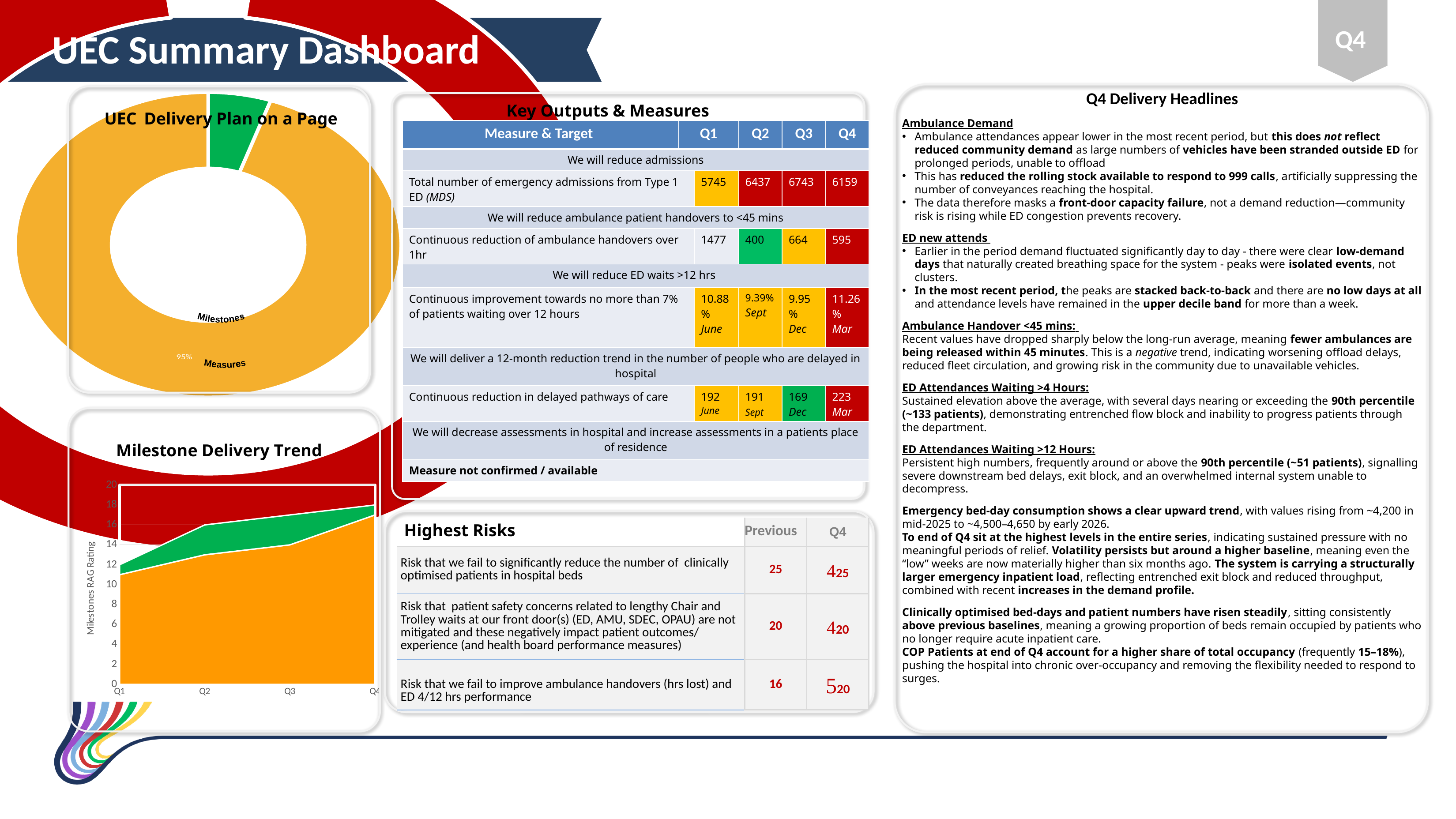
In the 'Milestone Delivery Trend' chart, in which quarter is the orange area lowest? Q1 In the 'Milestone Delivery Trend' chart, is the top of the orange area at Q1 greater or less than 12? less How many quarters are shown on the x axis of the 'Milestone Delivery Trend' chart? 4 What kind of chart is the 'UEC Delivery Plan on a Page' chart? Doughnut chart In the 'Milestone Delivery Trend' chart, is the top of the orange area at Q2 greater or less than 16? less In the 'Milestone Delivery Trend' chart, in which quarter is the orange area highest? Q4 In the 'Milestone Delivery Trend' chart, does the orange area rise or fall from Q1 to Q4? Rise What is the label on the y axis of the 'Milestone Delivery Trend' chart? Milestones RAG Rating What kind of chart is the 'Milestone Delivery Trend' chart? Area chart In the 'Milestone Delivery Trend' chart, is the orange area larger at Q4 or at Q1? Q4 What is the highest value shown on the y axis of the 'Milestone Delivery Trend' chart? 20 In the 'Milestone Delivery Trend' chart, is the top of the orange area at Q4 greater or less than 16? greater